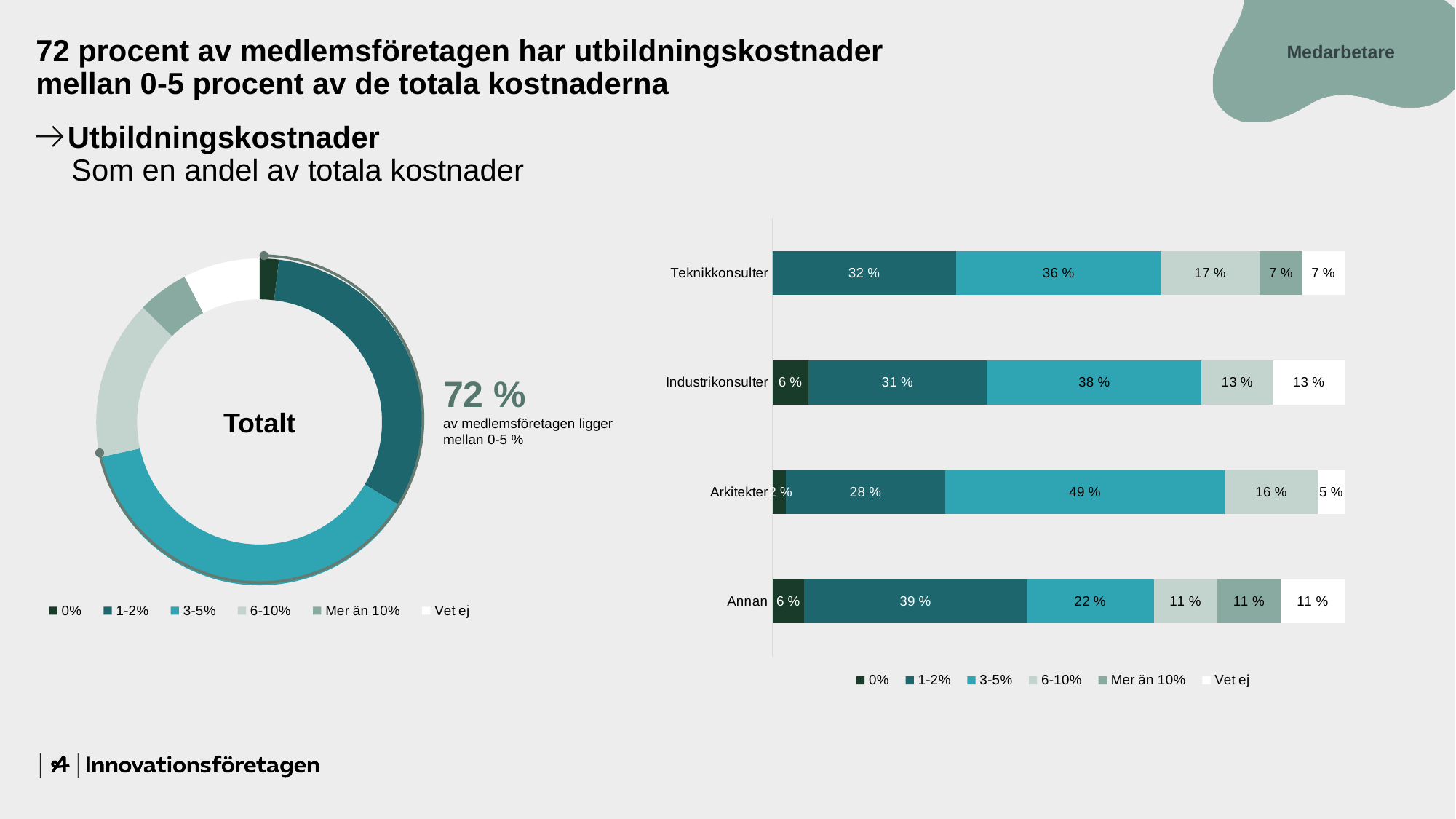
In the bar chart on the right, how many series does the legend list? 6 What kind of chart is the chart on the right of the slide? bar chart In the bar chart on the right, which category has the highest 3-5% share? Arkitekter In the bar chart on the right, what is the value of the 3-5% segment for Arkitekter? 49 % In the bar chart on the right, what is the value of the 1-2% segment for Annan? 39 % In the bar chart on the right, what is the difference between the 3-5% segment for Arkitekter and the 3-5% segment for Annan? 27 % What kind of chart is the chart on the left of the slide (labelled "Totalt")? donut chart In the bar chart on the right, what is the value of the 3-5% segment for Industrikonsulter? 38 % In the bar chart on the right, which category has the lowest 1-2% share? Arkitekter In the bar chart on the right, which is larger: the 3-5% segment for Teknikkonsulter or for Annan? Teknikkonsulter In the bar chart on the right, how many categories are shown? 4 In the bar chart on the right, what is the value of the Vet ej segment for Teknikkonsulter? 7 %